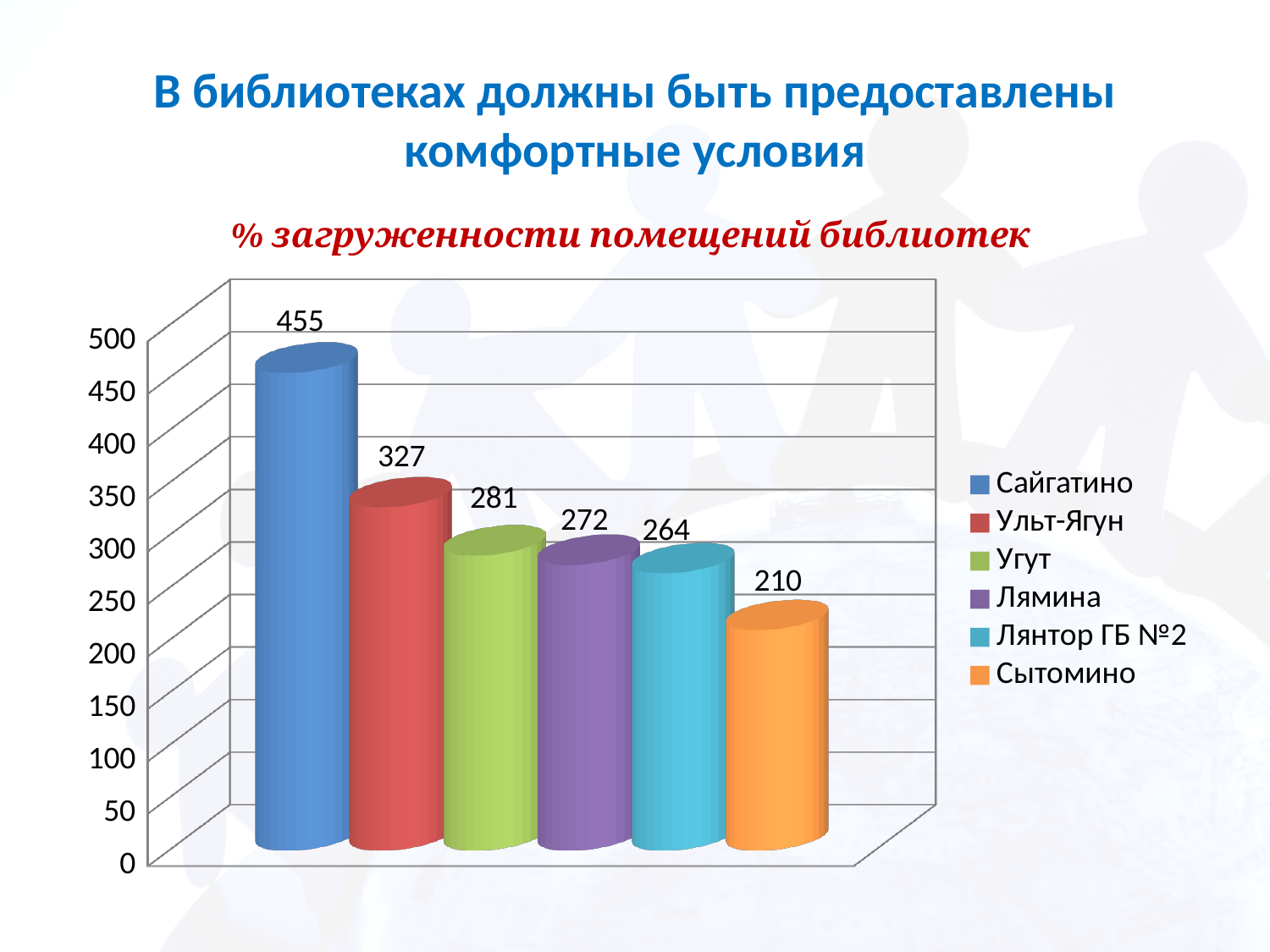
Which library has the lowest value? Сытомино What is the title of the chart? % загруженности помещений библиотек What is the difference between the values for Ульт-Ягун and Угут? 46 Which library has the highest value? Сайгатино What is the value for Лянтор ГБ №2? 264 Which is larger, the value for Угут or the value for Лямина? Угут What is the value for Ульт-Ягун? 327 How many entries does the legend list? 6 What is the value for Сайгатино? 455 What kind of chart is shown on the slide? bar chart How many bars are shown in the chart? 6 What is the difference between the values for Сайгатино and Сытомино? 245